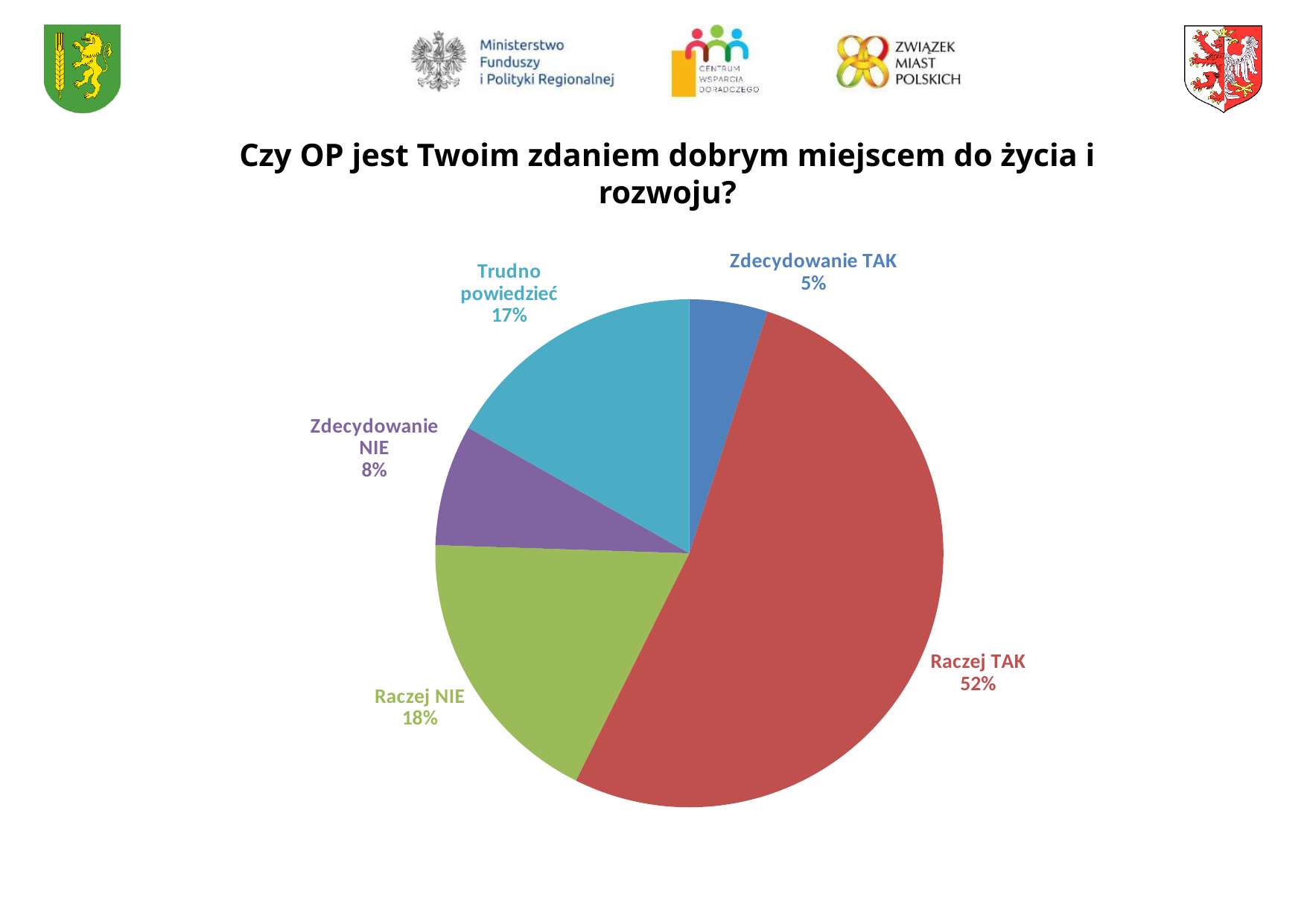
What percentage is shown for "Zdecydowanie TAK"? 5% Which response category has the largest slice of the pie? Raczej TAK What is the difference in percentage points between "Raczej TAK" and "Raczej NIE"? 34 Which response category has the smallest slice of the pie? Zdecydowanie TAK What kind of chart is shown on the slide? Pie chart What is the title of the chart on the slide? Czy OP jest Twoim zdaniem dobrym miejscem do życia i rozwoju? How many response categories are shown in the pie chart? 5 What is the combined share of "Zdecydowanie TAK" and "Raczej TAK"? 57% Which is larger, the share for "Raczej NIE" or the share for "Trudno powiedzieć"? Raczej NIE What percentage of respondents answered "Raczej TAK"? 52% What is the value shown for "Zdecydowanie NIE"? 8% What share of the pie is labelled "Trudno powiedzieć"? 17%